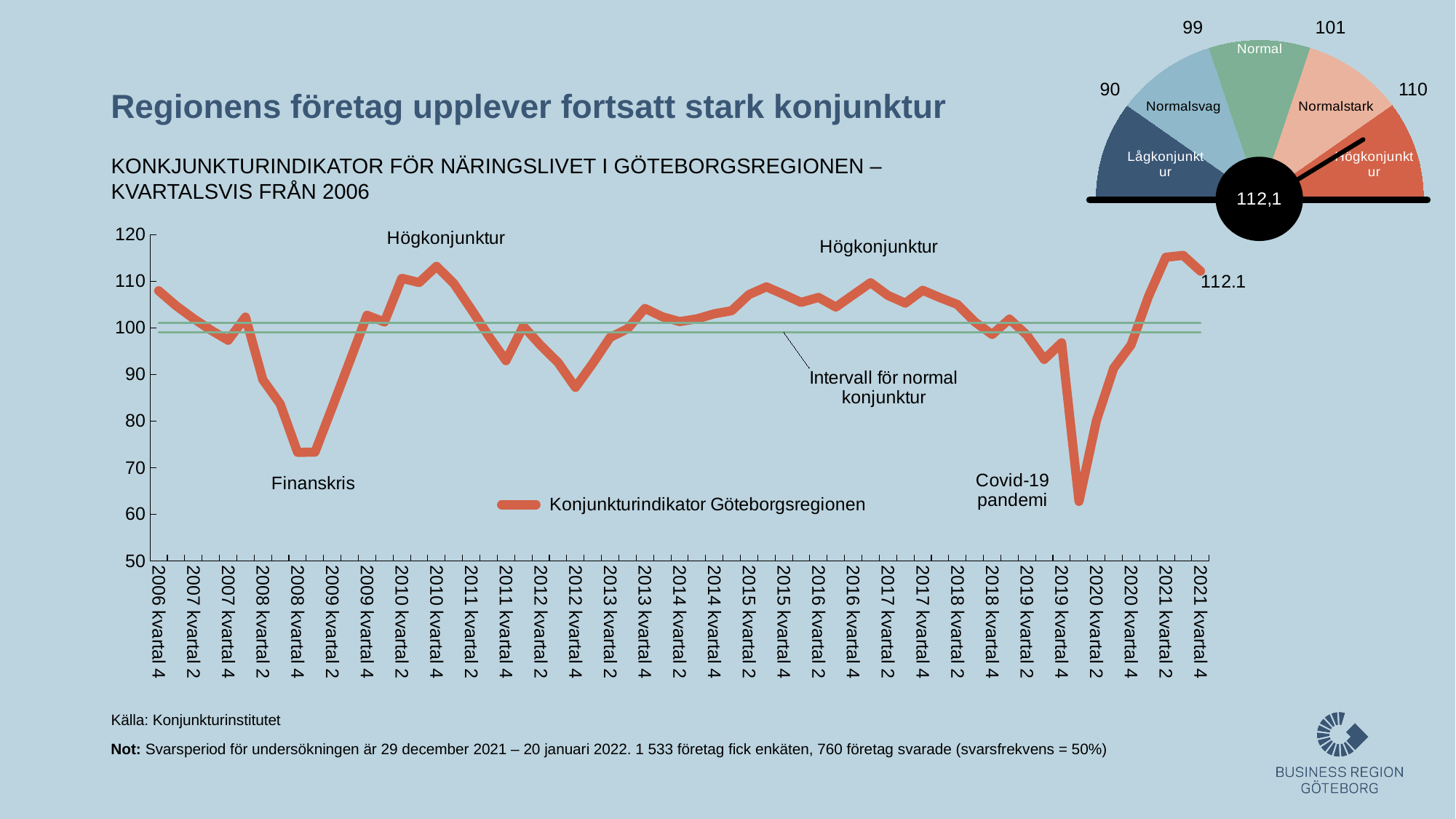
In the gauge chart at the top right, what value is shown in the centre? 112,1 In the gauge chart, which segment does the needle point to? Högkonjunktur In the line chart, is the value for 2008 kvartal 4 greater or less than 80? less How many series does the legend of the line chart list? 1 In the line chart, which is larger, the value for 2006 kvartal 4 or the value for 2012 kvartal 4? 2006 kvartal 4 How many segments does the gauge chart at the top right have? 5 In the line chart, is the value for 2020 kvartal 2 greater or less than 70? greater What kind of chart is the main chart showing the Konjunkturindikator from 2006? line chart In the line chart, what is the value printed for the last point, 2021 kvartal 4? 112.1 In the gauge chart, what value marks the boundary between Normalstark and Högkonjunktur? 110 What is the name of the series shown in the legend of the line chart? Konjunkturindikator Göteborgsregionen In the line chart, which quarter has the lowest value? 2020 kvartal 1